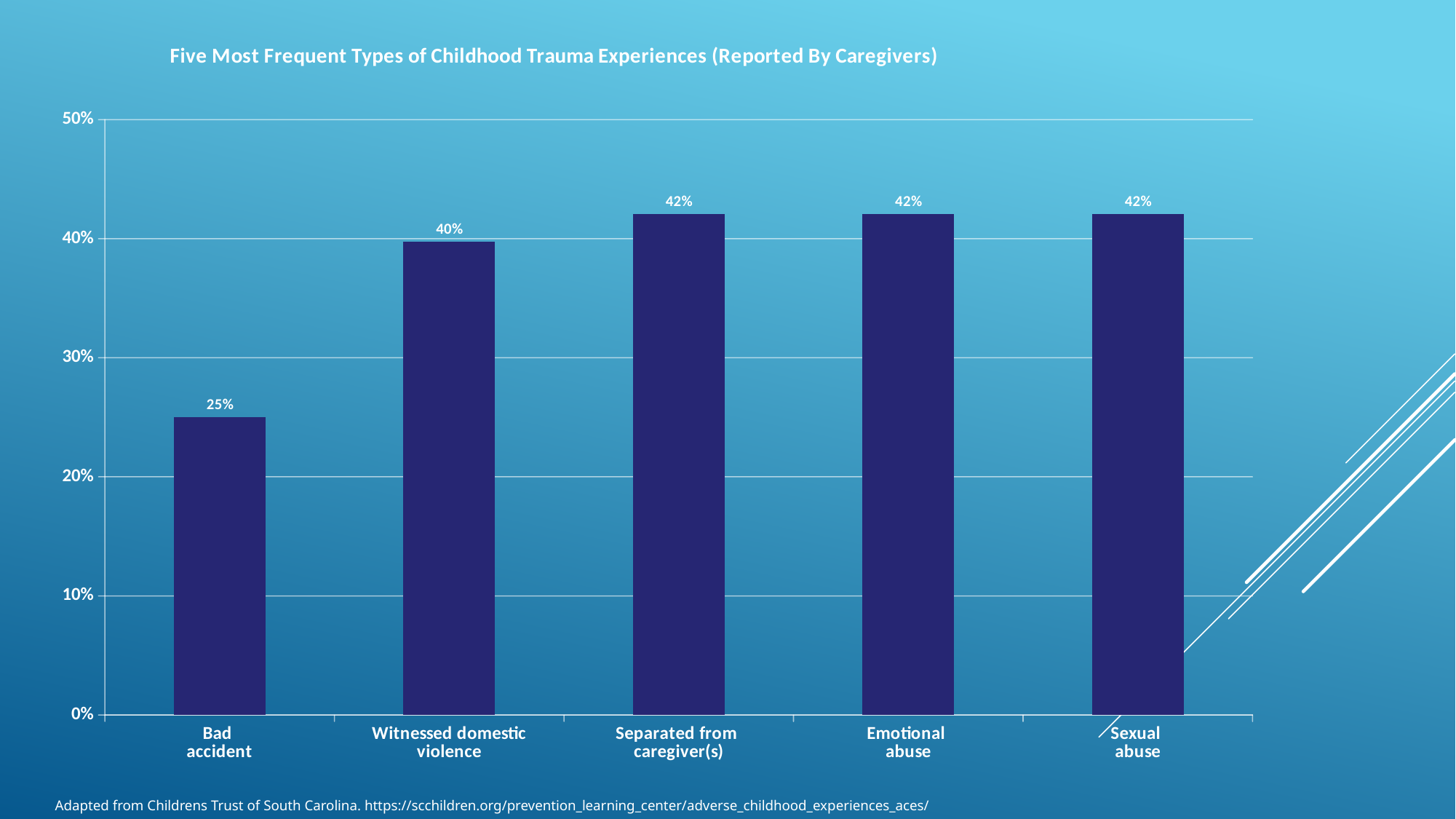
What percentage is shown for Witnessed domestic violence? 40% What is the difference between the values for Separated from caregiver(s) and Bad accident? 17% What is the title of the chart? Five Most Frequent Types of Childhood Trauma Experiences (Reported By Caregivers) What is the difference between the values for Sexual abuse and Witnessed domestic violence? 2% Is the value for Bad accident greater or less than 30%? less How many categories share the highest value of 42%? 3 What percentage is shown for Bad accident? 25% What kind of chart is shown on the slide? bar chart Which category has the lowest value? Bad accident What percentage is shown for Emotional abuse? 42% How many categories are shown on the chart? 5 Which is larger, the value for Witnessed domestic violence or the value for Bad accident? Witnessed domestic violence